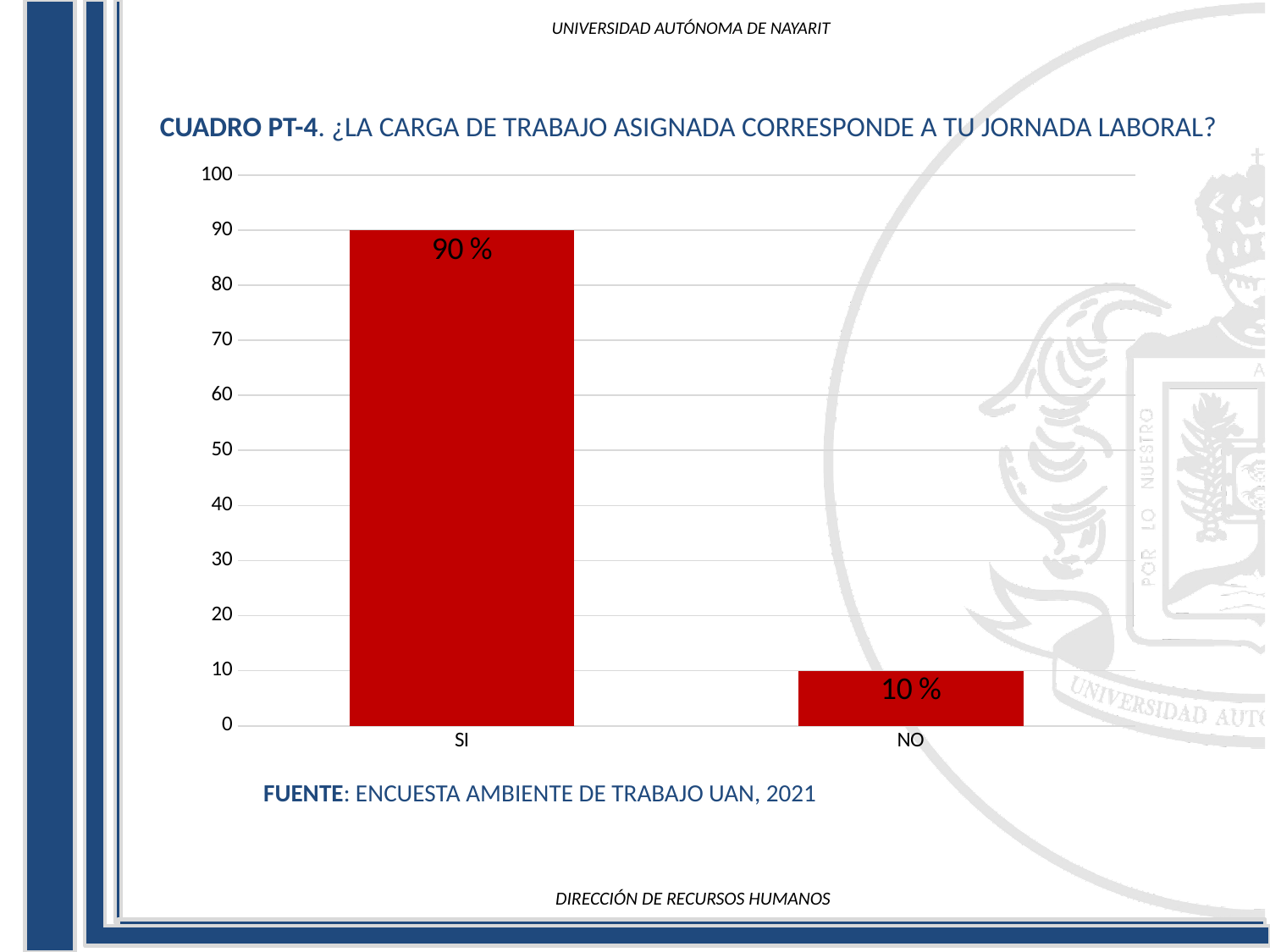
What is the title of the chart? CUADRO PT-4. ¿LA CARGA DE TRABAJO ASIGNADA CORRESPONDE A TU JORNADA LABORAL? Which category has the highest value? SI What is the value for SI? 90 % Is the value for SI greater or less than 50? greater What colour are the bars in the chart? red Which category has the lowest value? NO What kind of chart is shown on the slide? bar chart How many categories are shown on the x axis? 2 What is the difference between the values for SI and NO? 80 % Is the value for NO greater or less than 20? less What is the value for NO? 10 % Which is larger, the value for SI or the value for NO? SI